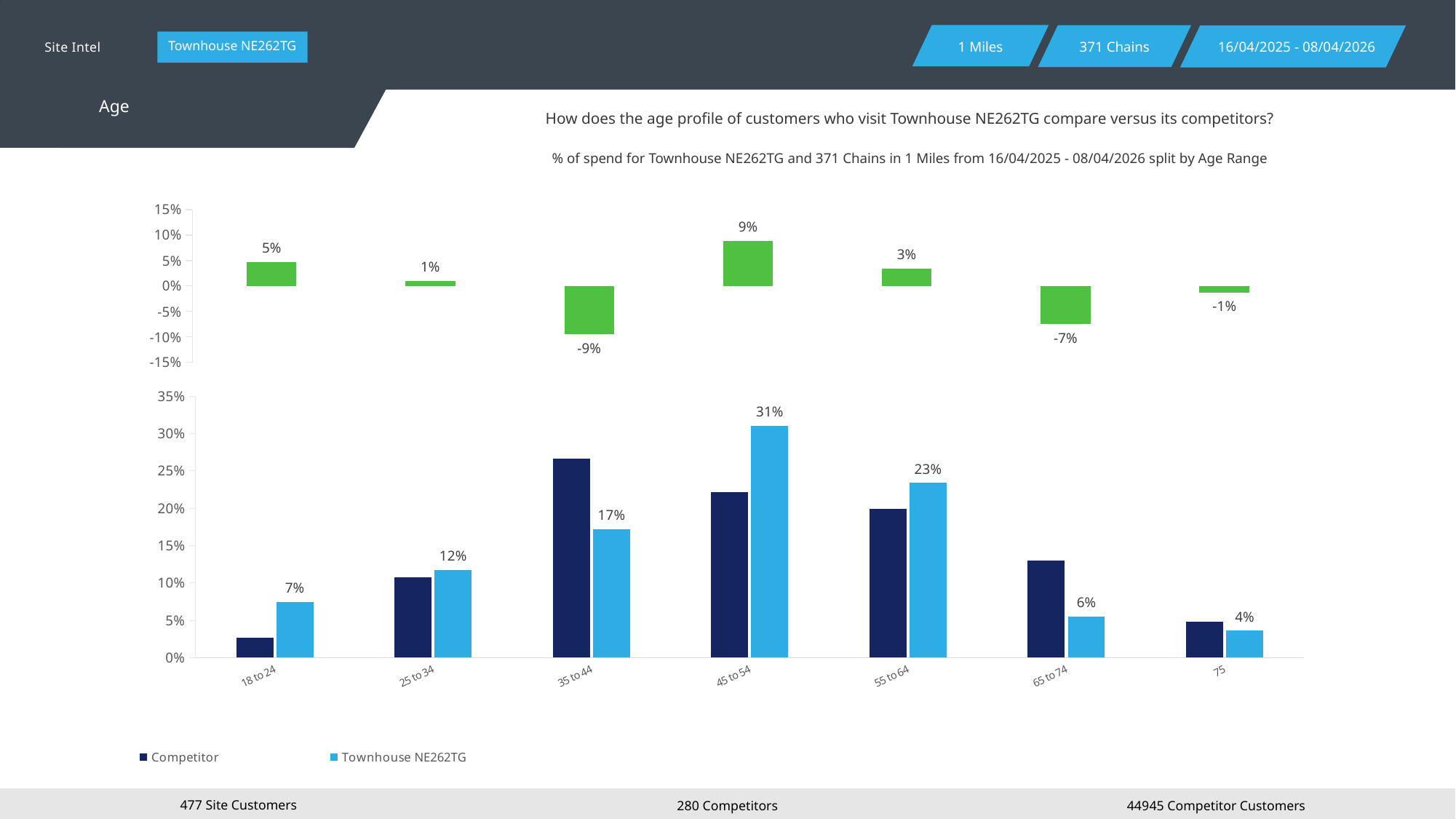
In the bottom chart, is the Competitor value for 18 to 24 greater or less than 5%? less In the bottom chart, what is the difference between the Townhouse NE262TG values for 45 to 54 and 55 to 64? 8 percentage points In the bottom chart, which age range has the highest Townhouse NE262TG value? 45 to 54 In the bottom chart, which age range has the lowest Townhouse NE262TG value? 75 In the bottom chart, what is the value for Townhouse NE262TG in the 18 to 24 age range? 7% How many series does the legend of the bottom chart list? 2 In the bottom chart, what is the value for Townhouse NE262TG in the 45 to 54 age range? 31% In the bottom chart, for the 35 to 44 age range, which is larger: Competitor or Townhouse NE262TG? Competitor In the bottom chart, is the Competitor value for 35 to 44 greater or less than 25%? greater In the top chart, which age range has the highest value? 45 to 54 In the top chart, what is the value shown for the 35 to 44 age range? -9% How many age range categories are shown on the x axis of the bottom chart? 7